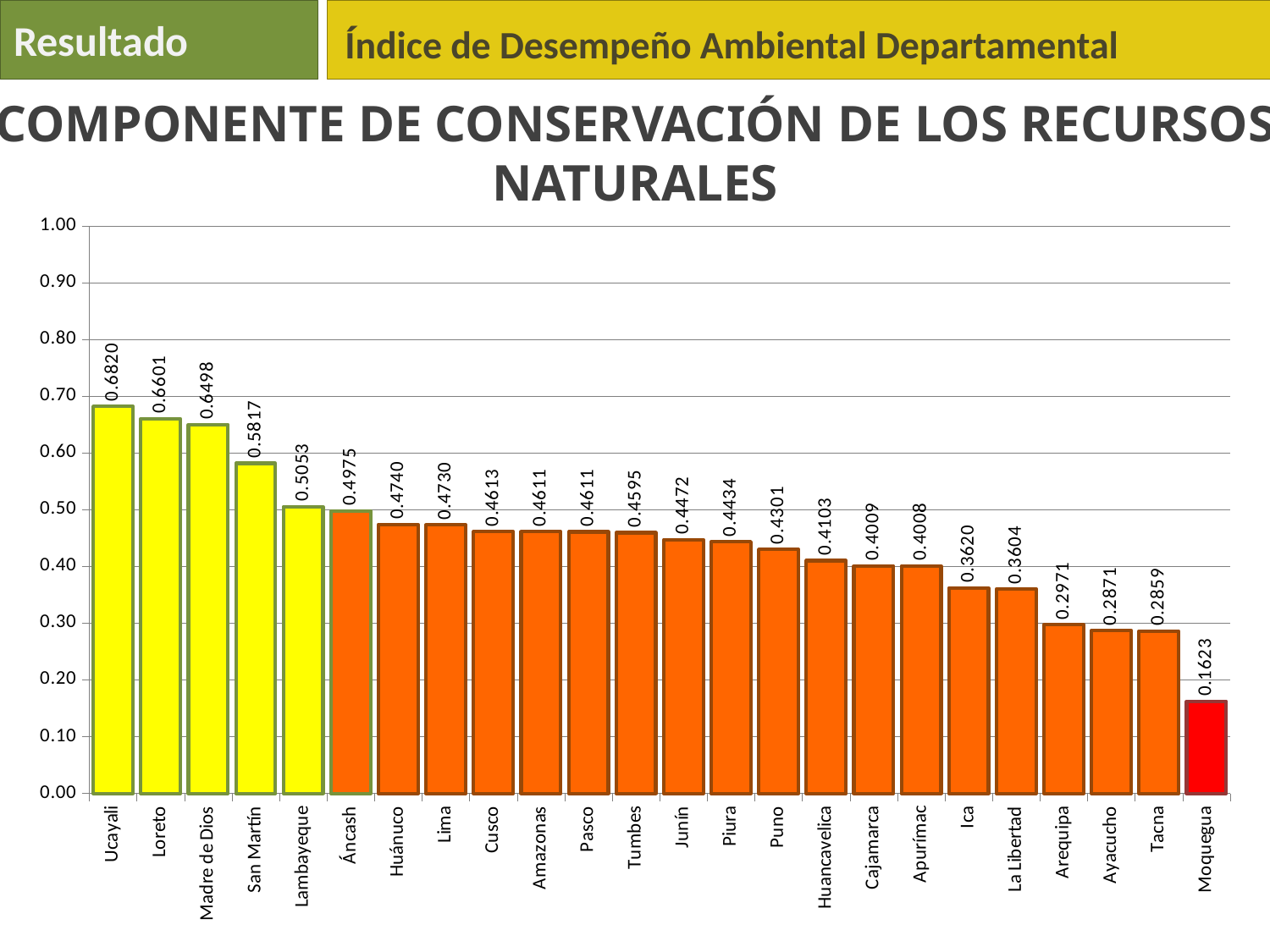
What is the value for Ucayali? 0.6820 Which department has the highest value? Ucayali How many departments are shown in the chart? 24 What is the value for Lima? 0.4730 Which has a larger value, San Martín or Áncash? San Martín What is the difference between the values for Ucayali and Moquegua? 0.5197 What type of chart is shown? Bar chart Which department has the lowest value? Moquegua What is the value for Cajamarca? 0.4009 Do the values rise or fall from left to right along the x axis? Fall What is the difference between the values for Loreto and Lima? 0.1871 What is the value for Moquegua? 0.1623